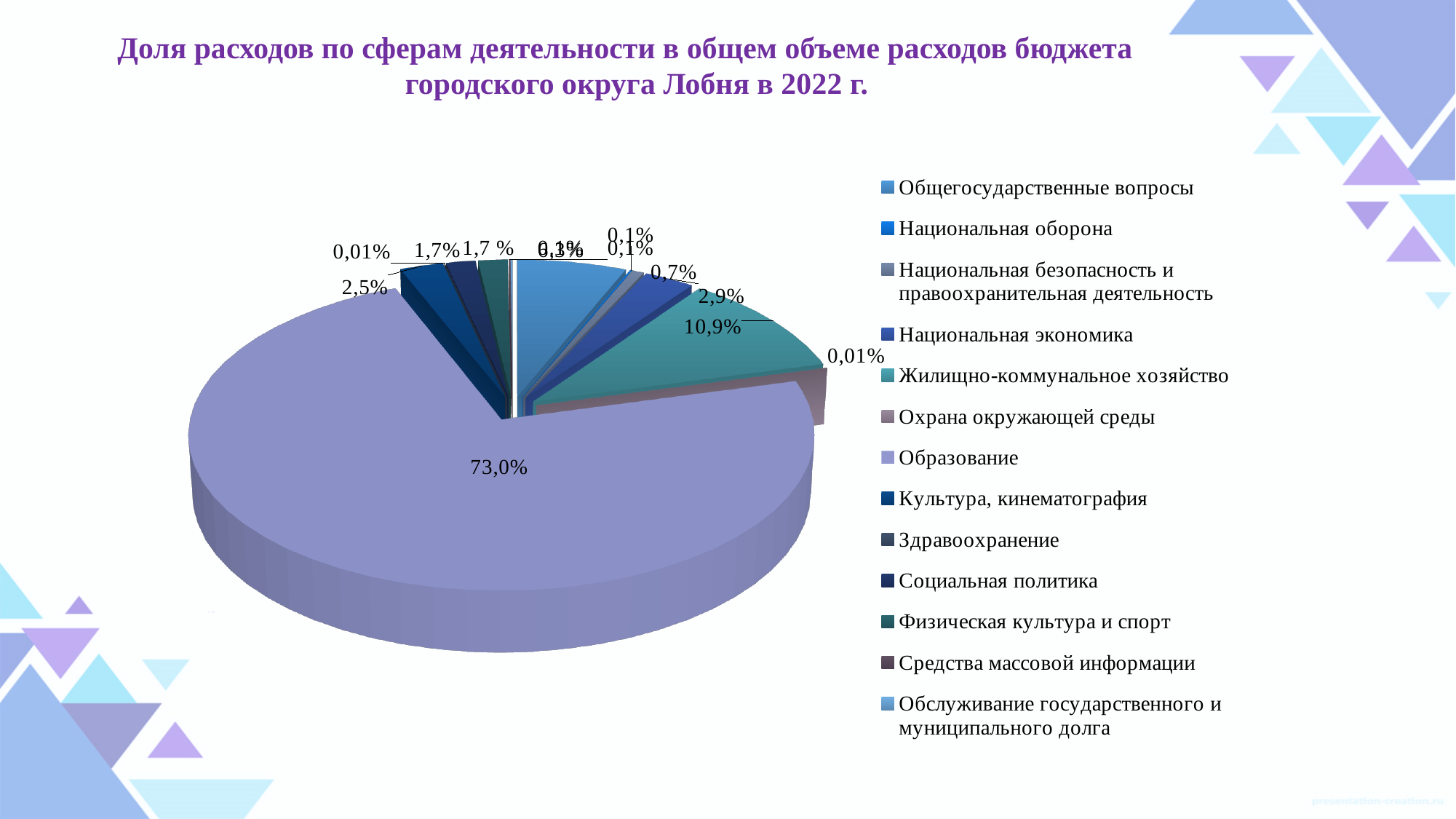
What kind of chart is shown on the slide? pie chart What share of budget expenditure does Образование account for? 73,0% What is the difference between the share for Образование and the share for Жилищно-коммунальное хозяйство? 62,1% What share of budget expenditure does Жилищно-коммунальное хозяйство account for? 10,9% What share of budget expenditure does Культура, кинематография account for? 2,5% How many categories does the legend list? 13 Which legend entry is listed last? Обслуживание государственного и муниципального долга Which is larger, the share for Образование or the share for Жилищно-коммунальное хозяйство? Образование Which category has the largest share of the pie? Образование Which year does the chart title refer to? 2022 What share of budget expenditure does Национальная экономика account for? 2,9%